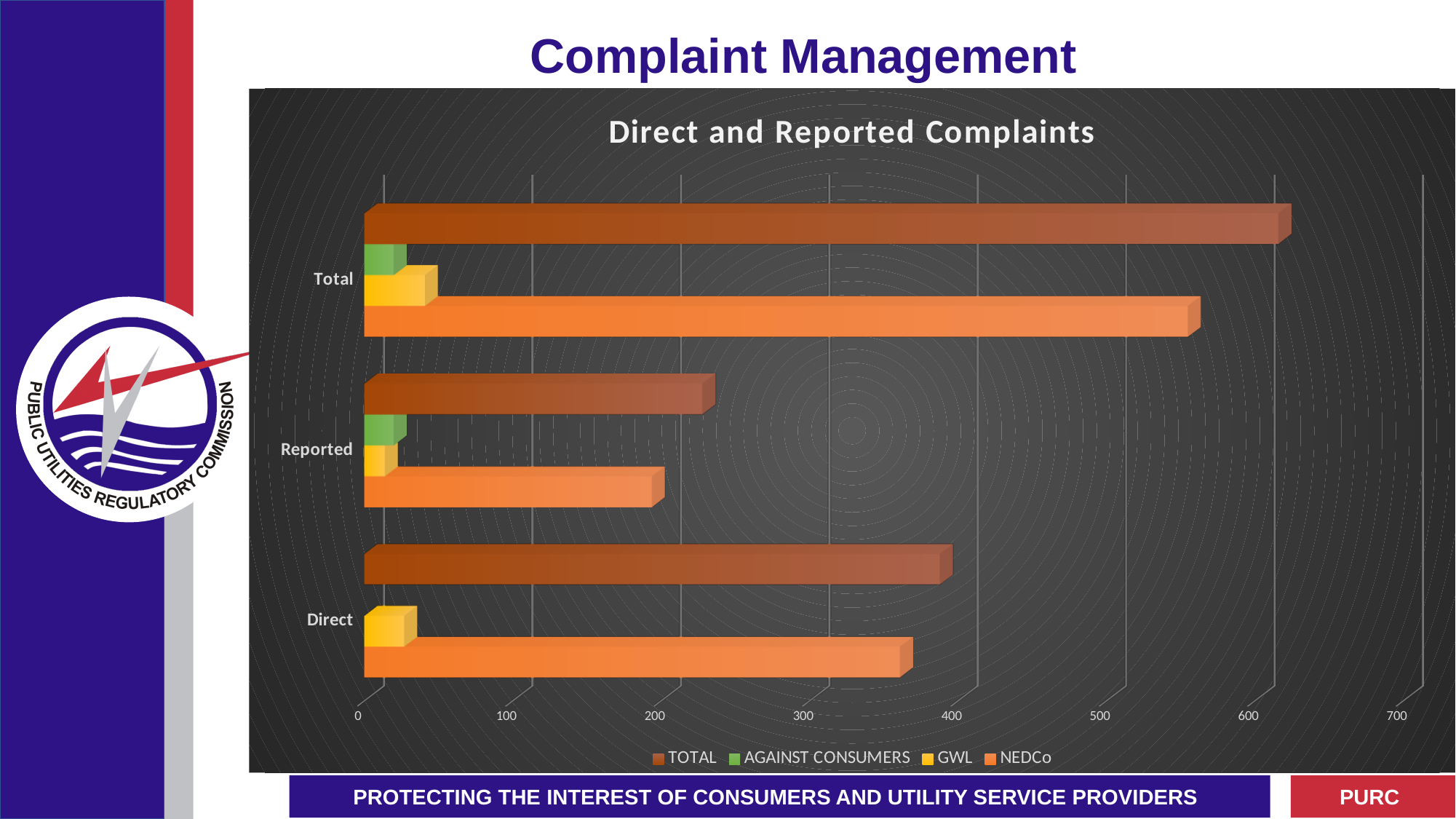
What is the title of the chart? Direct and Reported Complaints Which series is shown in green in the legend? AGAINST CONSUMERS Is the TOTAL value for the Reported category greater or less than 300? less Is the TOTAL value for the Total category greater or less than 500? greater Which category has the highest TOTAL value? Total Which is larger, the TOTAL value for Direct or the TOTAL value for Reported? Direct Is the NEDCo value for the Total category greater or less than 500? greater How many categories are shown on the vertical axis? 3 What type of chart is shown on the slide? Bar chart Which category has the lowest TOTAL value? Reported How many series does the legend list? 4